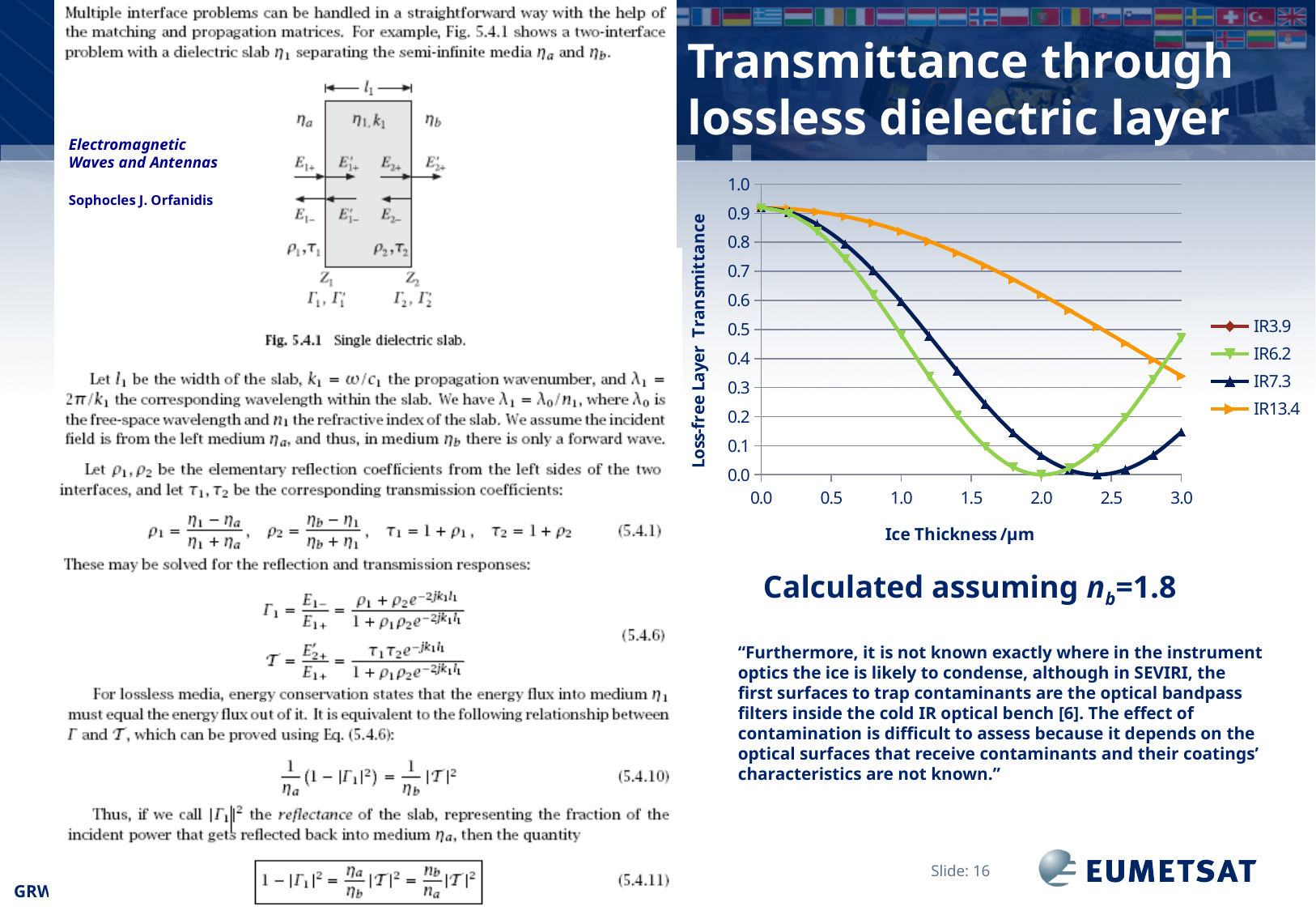
Is the value for IR13.4 at an ice thickness of 1.0 μm greater or less than 0.8? greater At an ice thickness of 3.0 μm, which series has the larger transmittance, IR6.2 or IR13.4? IR6.2 Is the value for IR13.4 at an ice thickness of 3.0 μm greater or less than 0.4? less What kind of chart is shown on the slide? line chart Is the value for IR7.3 at an ice thickness of 3.0 μm greater or less than 0.2? less At an ice thickness of 1.5 μm, which series has the larger transmittance, IR7.3 or IR13.4? IR13.4 What is the title of the y axis of the chart? Loss-free Layer Transmittance Does the IR13.4 series rise or fall as ice thickness increases from 0.0 to 3.0 μm? fall How many series does the chart legend list? 4 What is the title of the x axis of the chart? Ice Thickness /μm